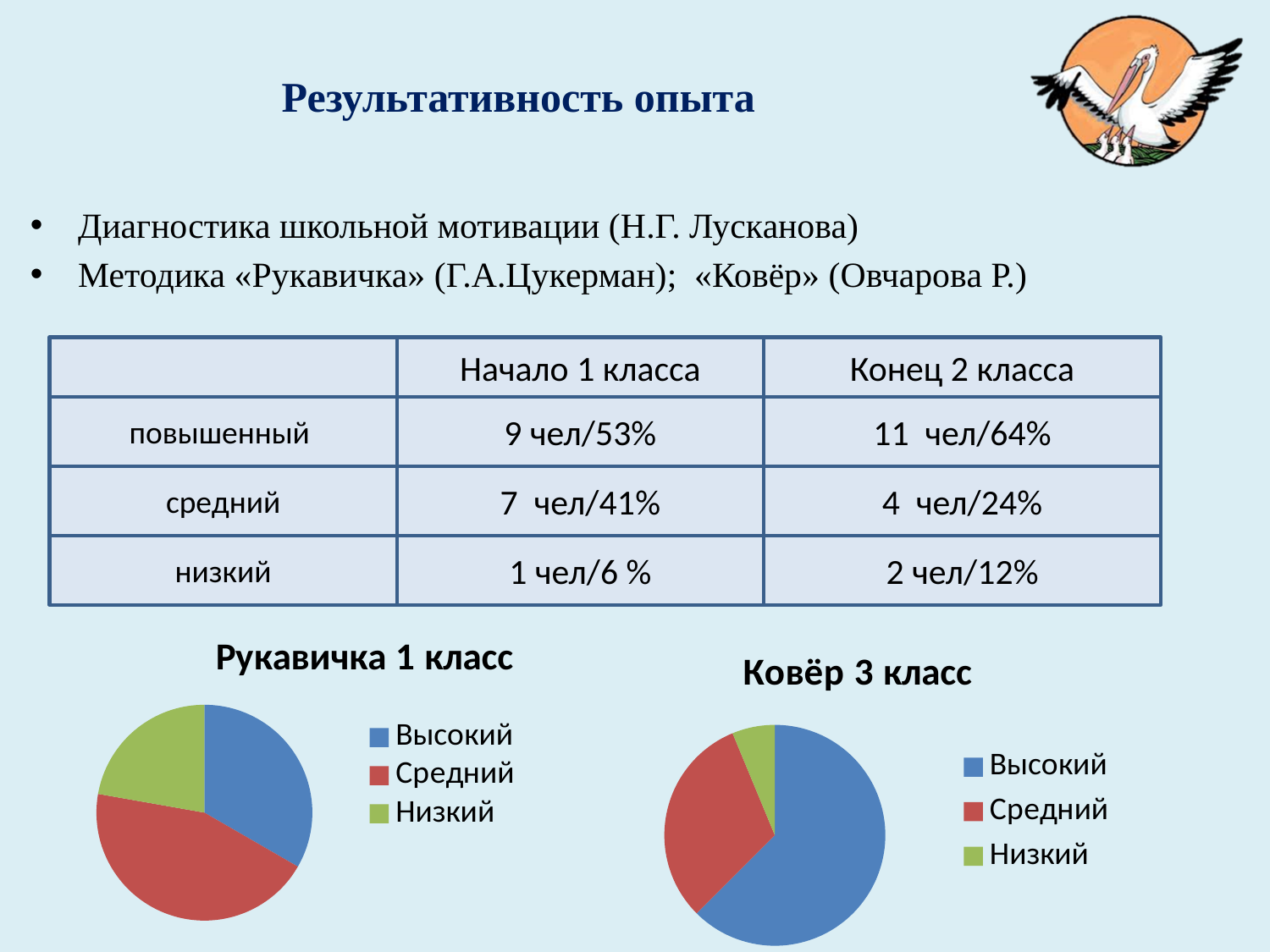
In the "Ковёр 3 класс" chart, what colour is the Средний slice? red How many entries does the legend of the "Рукавичка 1 класс" chart list? 3 How many slices does the "Ковёр 3 класс" pie chart have? 3 In the "Ковёр 3 класс" chart, which slice is larger: Высокий or Средний? Высокий In the "Ковёр 3 класс" chart, which category has the largest slice? Высокий In the "Ковёр 3 класс" chart, which category has the smallest slice? Низкий In the "Рукавичка 1 класс" chart, which slice is larger: Средний or Низкий? Средний What kind of chart is "Рукавичка 1 класс"? pie chart In the "Рукавичка 1 класс" chart, which category has the largest slice? Средний What kind of chart is "Ковёр 3 класс"? pie chart In the "Рукавичка 1 класс" chart, which category has the smallest slice? Низкий What is the title of the pie chart on the left of the slide? Рукавичка 1 класс